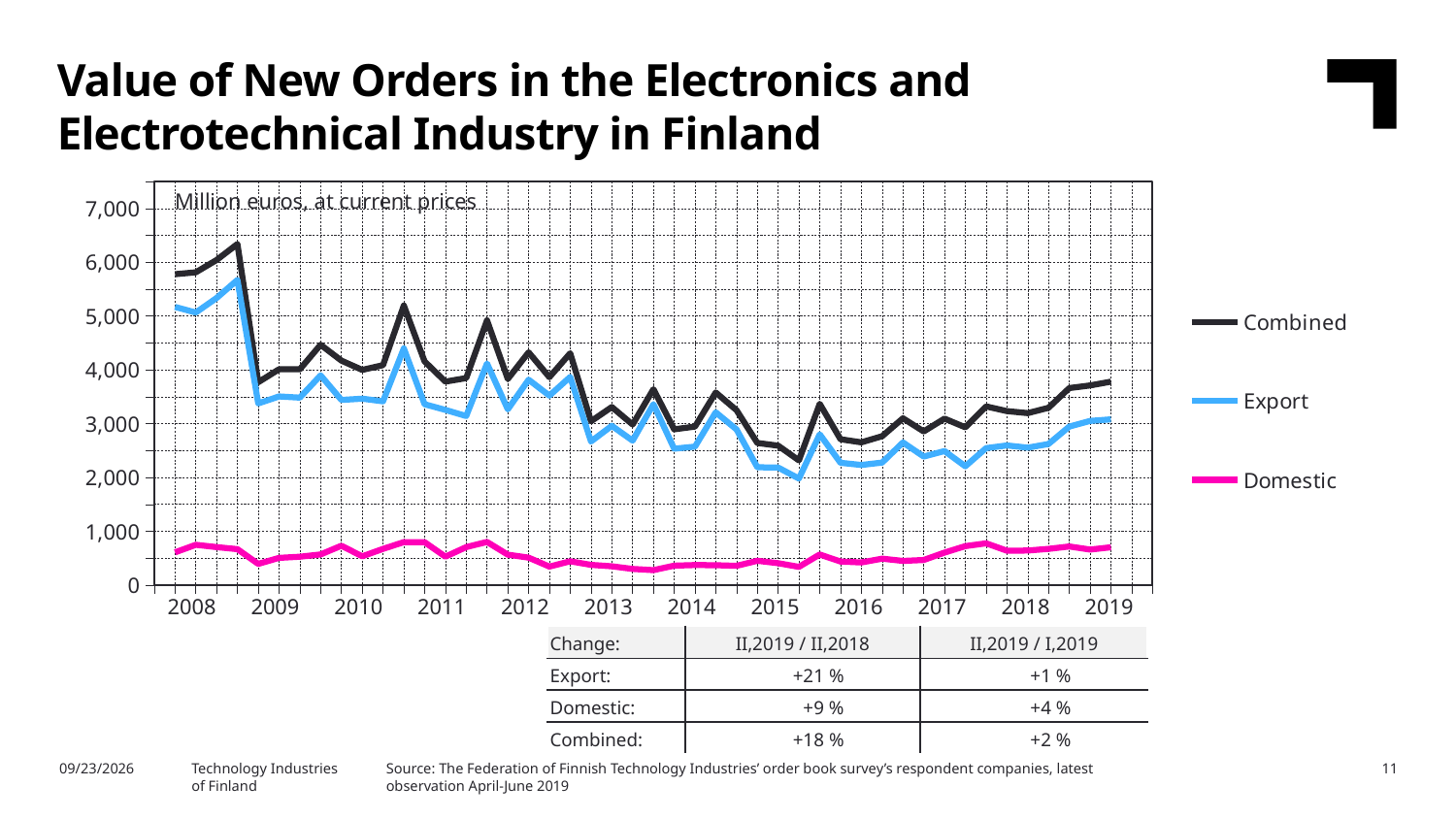
Is the value for Export in 2015 greater or less than 3,000? less How many years are labelled on the x axis? 12 What type of chart is shown on the slide? Line chart In 2019, which is larger, Export or Domestic? Export Which series is plotted highest across the whole period? Combined Is the value for Combined in 2019 greater or less than 4,000? less What unit does the chart state the values are in? Million euros, at current prices Is the value for Combined at the start of 2008 greater or less than 5,000? greater Which series is plotted lowest across the whole period? Domestic Does the Combined series rise or fall overall from 2008 to 2019? Fall How many series does the legend list? 3